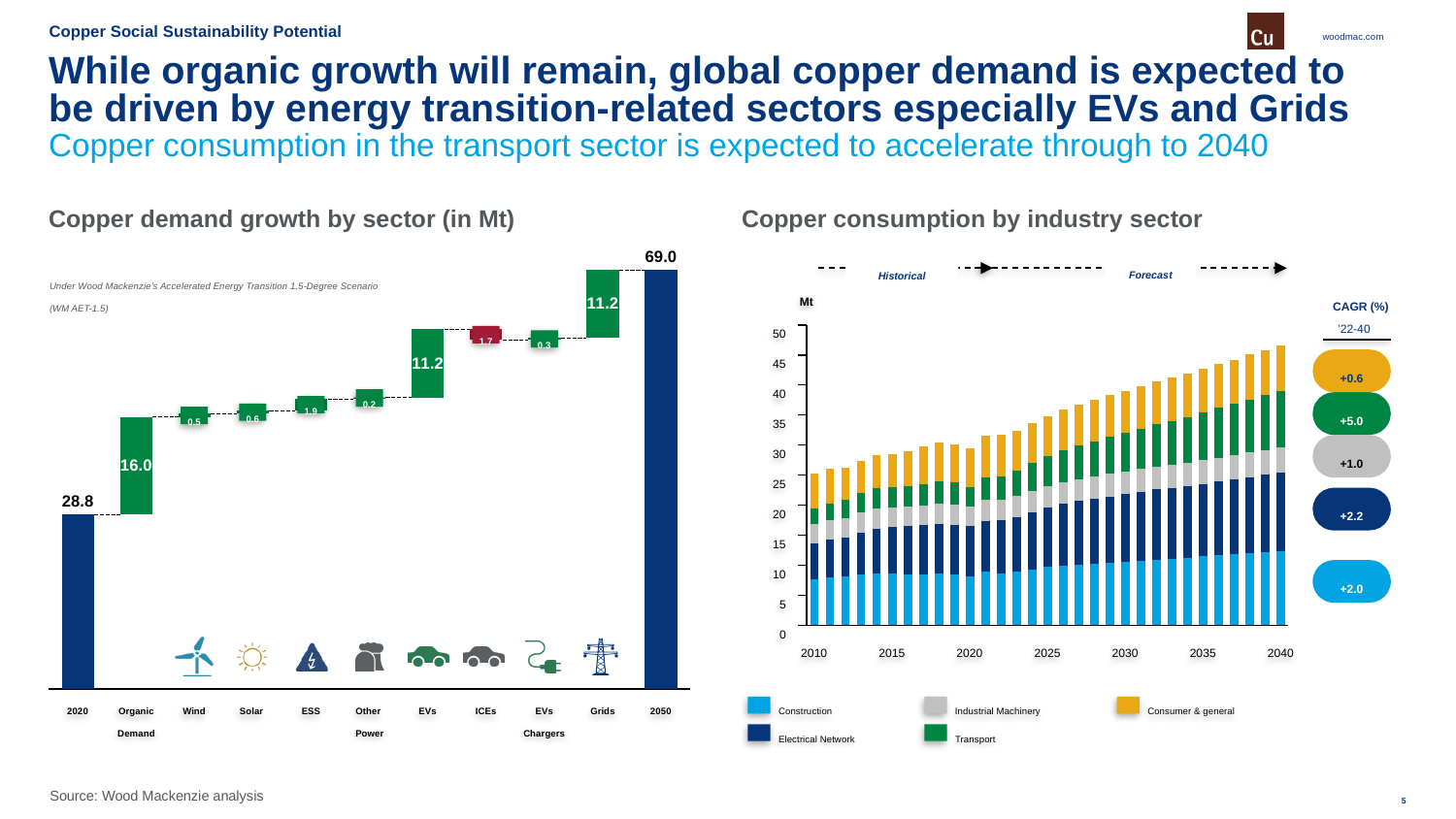
In the 'Copper consumption by industry sector' chart, do the total bar heights rise or fall from 2010 to 2040? Rise In the 'Copper demand growth by sector (in Mt)' chart, what is the difference between the 2050 value and the 2020 value? 40.2 What kind of chart is 'Copper consumption by industry sector'? Stacked bar chart In the 'Copper demand growth by sector (in Mt)' chart, what is the value shown for 2020? 28.8 In the 'Copper demand growth by sector (in Mt)' chart, what is the value for ESS? 1.9 In the 'Copper demand growth by sector (in Mt)' chart, what is the value for Organic Demand? 16.0 In the 'Copper consumption by industry sector' chart, is the total for 2040 greater or less than 45? greater In the 'Copper demand growth by sector (in Mt)' chart, what is the value shown for 2050? 69.0 How many series does the legend of the 'Copper consumption by industry sector' chart list? 5 In the 'Copper demand growth by sector (in Mt)' chart, which is larger, the value for Wind or the value for Solar? Solar In the 'Copper demand growth by sector (in Mt)' chart, what is the value for Grids? 11.2 In the 'Copper demand growth by sector (in Mt)' chart, which category is shown in red as a reduction? ICEs